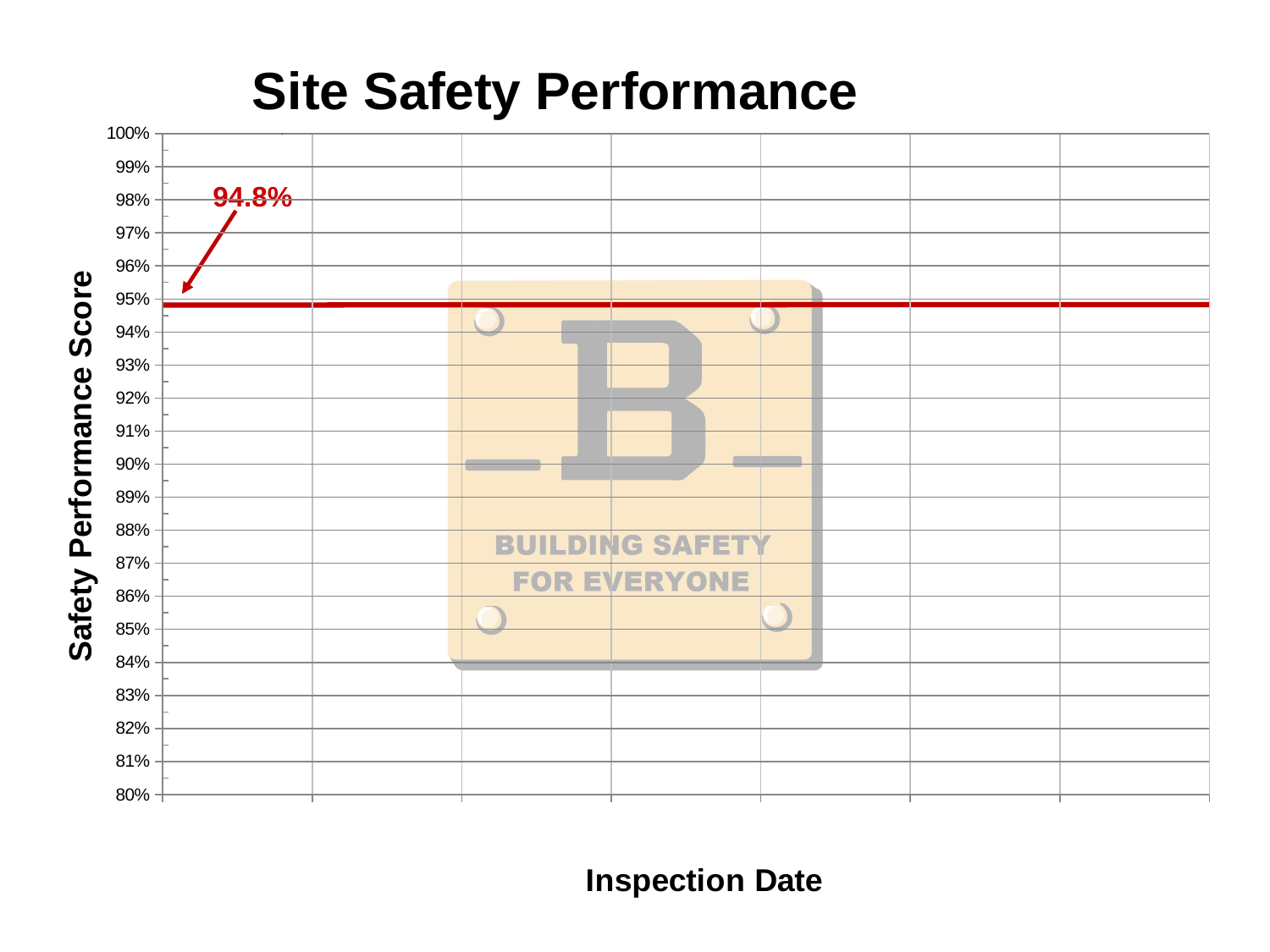
What is the title of the chart? Site Safety Performance Is the value of the red line greater or less than 95%? less Does the red line rise, fall, or stay flat along the x axis? stays flat What kind of chart is shown on the slide? line chart What is the lowest value shown on the vertical axis? 80% What is the highest value shown on the vertical axis? 100% Is the value of the red line greater or less than 90%? greater What value is labelled on the red line in the chart? 94.8% What is the label of the vertical axis? Safety Performance Score